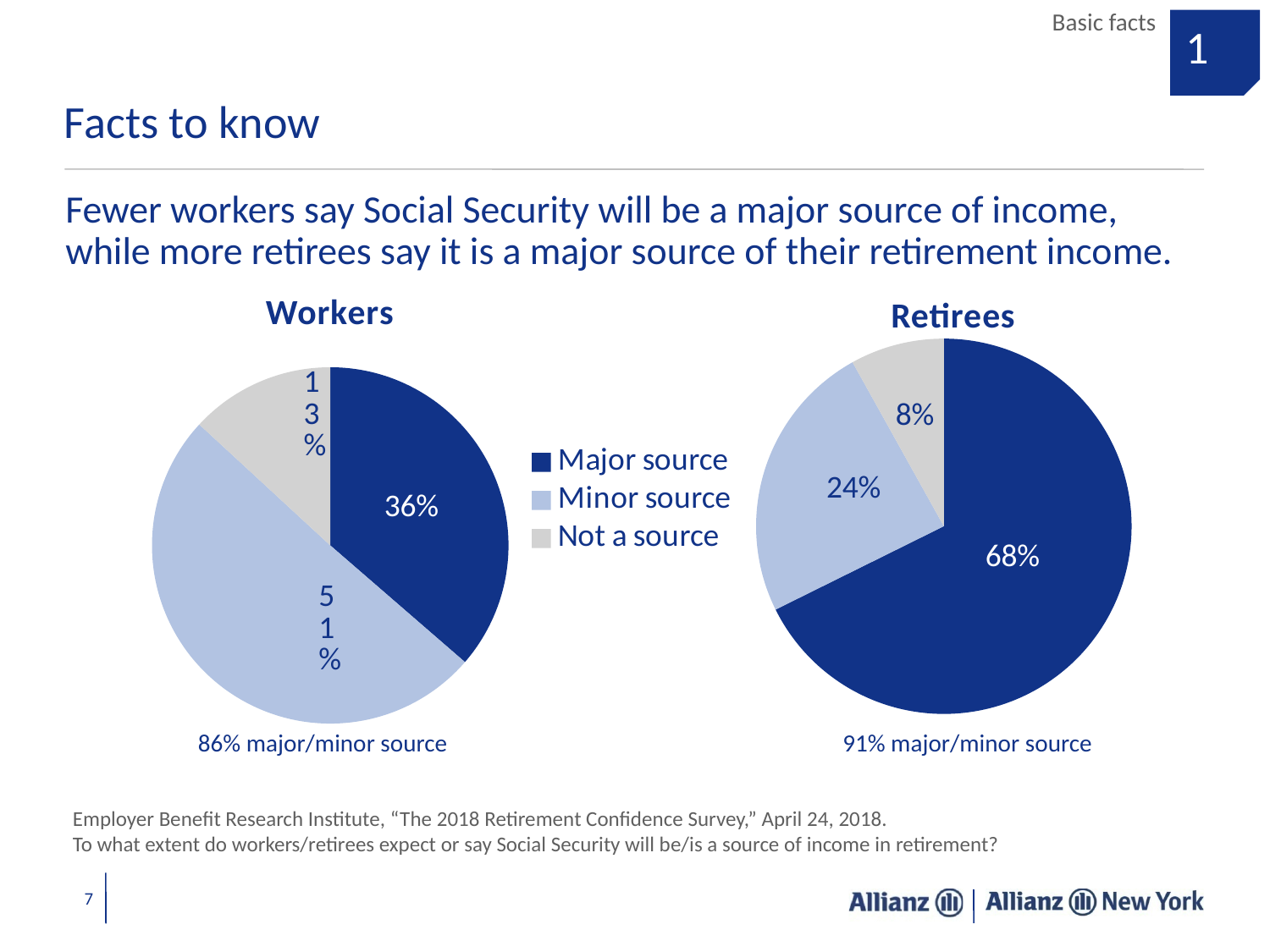
How many entries does the legend list? 3 Which is larger: the Workers' minor source share or the Retirees' minor source share? Workers' minor source share In the Retirees chart, which category has the smallest share? Not a source What kind of chart is the Retirees chart? Pie chart Which colour represents 'Not a source' in the legend? Light grey In the Retirees chart, what percentage say Social Security is not a source? 8% How many slices does the Workers pie chart have? 3 In the Workers chart, which category has the largest share? Minor source In the Workers chart, what percentage say Social Security will be a minor source? 51% What is the difference between the Retirees' major source share and the Workers' major source share? 32% In the Workers chart, what percentage say Social Security will be a major source of income? 36% In the Retirees chart, what percentage say Social Security is a major source of income? 68%